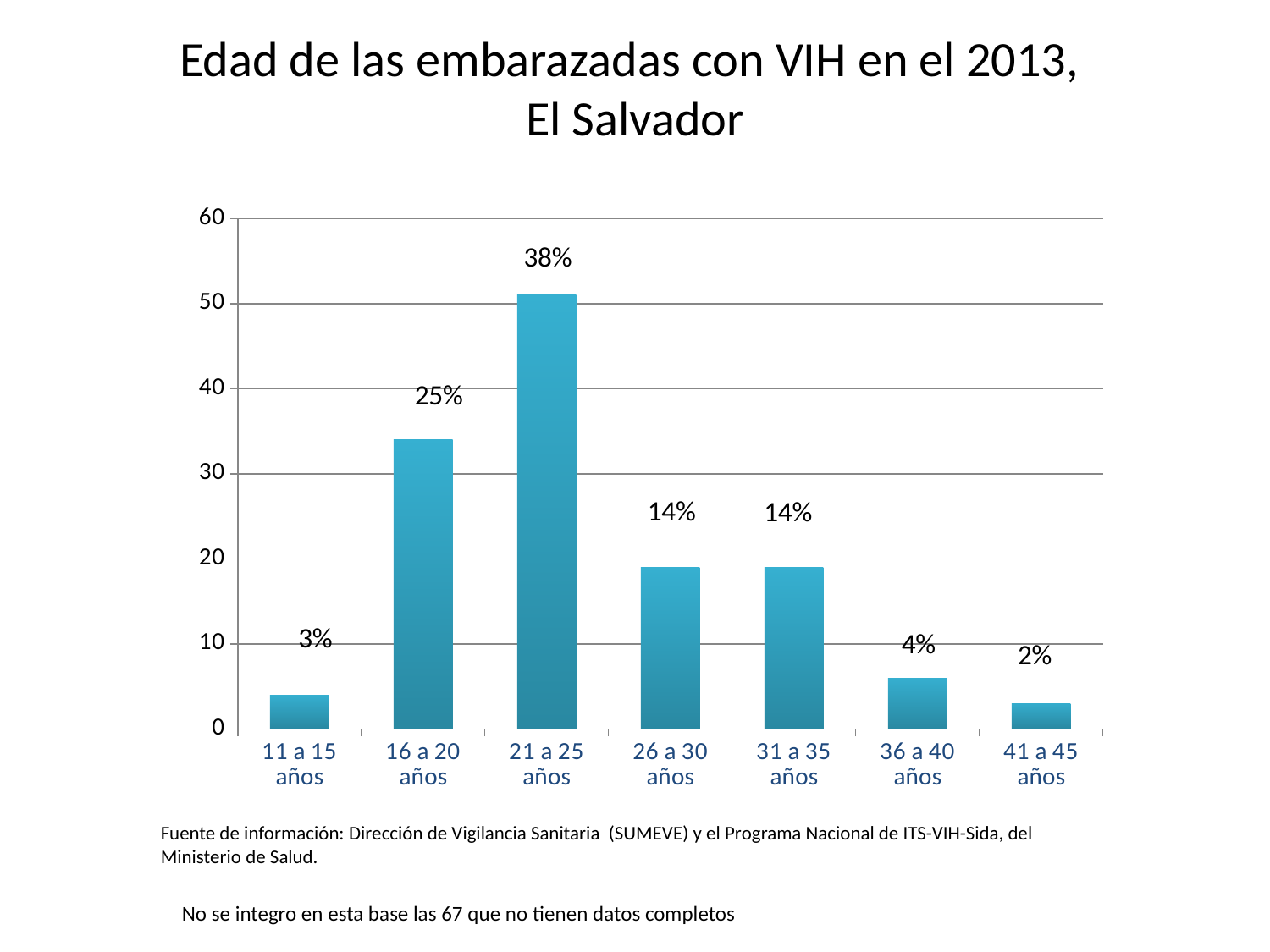
Is the value for 11 a 15 años greater or less than 10? less What is the data label shown for the 36 a 40 años bar? 4% What is the data label shown for the 41 a 45 años bar? 2% How many age groups are shown on the x axis? 7 Which age group has the highest bar? 21 a 25 años Is the value for 21 a 25 años greater or less than 50? greater Which bar is taller, 16 a 20 años or 26 a 30 años? 16 a 20 años What is the data label shown for the 21 a 25 años bar? 38% What is the difference between the percentage labels for 21 a 25 años and 16 a 20 años? 13% What is the data label shown for the 16 a 20 años bar? 25% Which age group has the lowest bar? 41 a 45 años What kind of chart is shown on the slide? bar chart